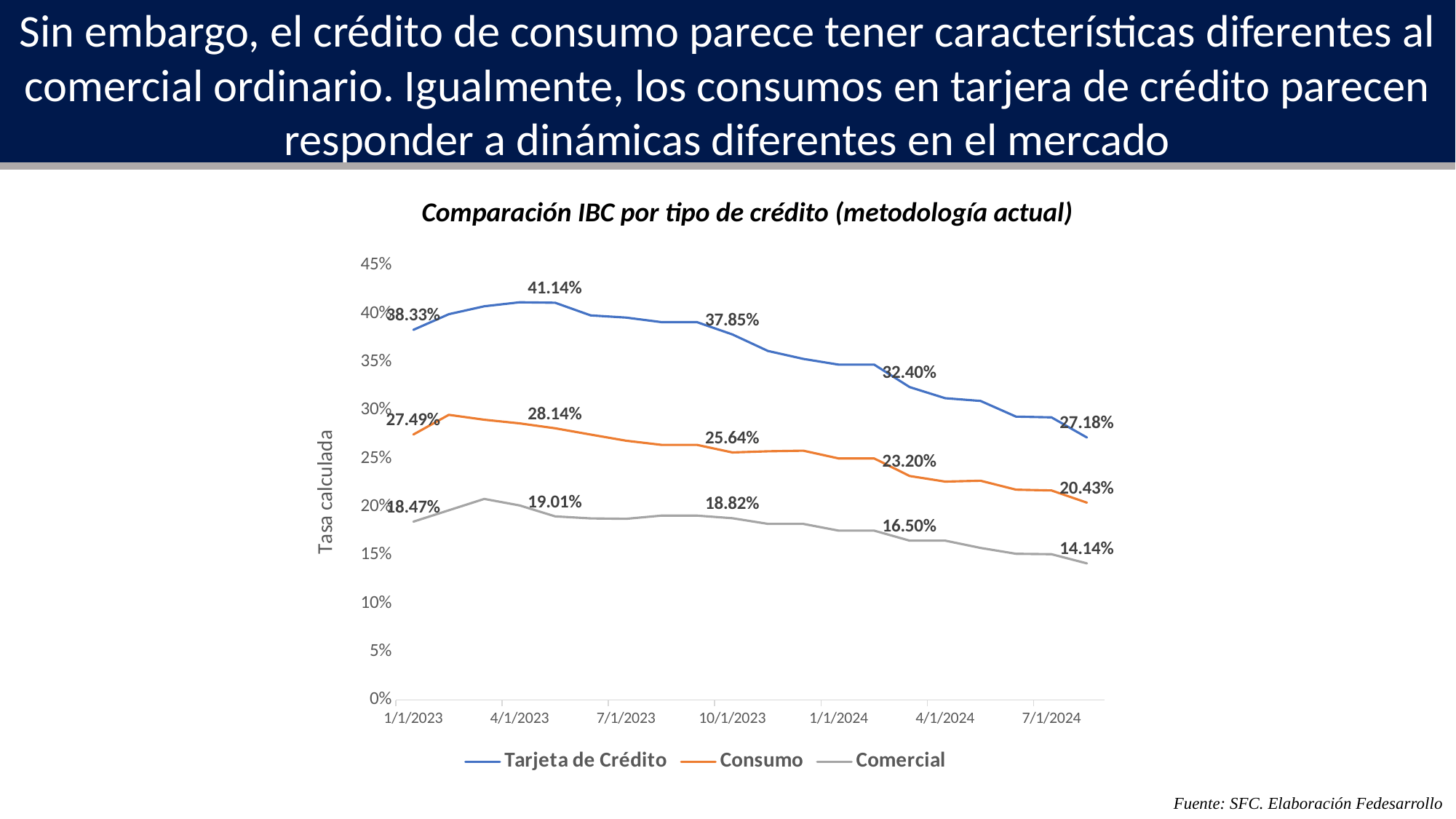
What is the highest labelled value for the Tarjeta de Crédito series? 41.14% Is the value for Comercial at 1/1/2023 greater or less than 20%? less What type of chart is shown on the slide? line chart What is the first labelled value for the Consumo series, at 1/1/2023? 27.49% What is the last labelled value for the Comercial series? 14.14% Does the Tarjeta de Crédito series generally rise or fall from 4/1/2023 to the end of the period? fall What is the title of the chart? Comparación IBC por tipo de crédito (metodología actual) How many series does the legend list? 3 What is the difference between the first labelled value (38.33%) and the last labelled value (27.18%) of the Tarjeta de Crédito series? 11.15% Which series has the higher value at the end of the period, Consumo or Comercial? Consumo What is the lowest labelled value for the Consumo series? 20.43% What is the last labelled value for the Tarjeta de Crédito series? 27.18%